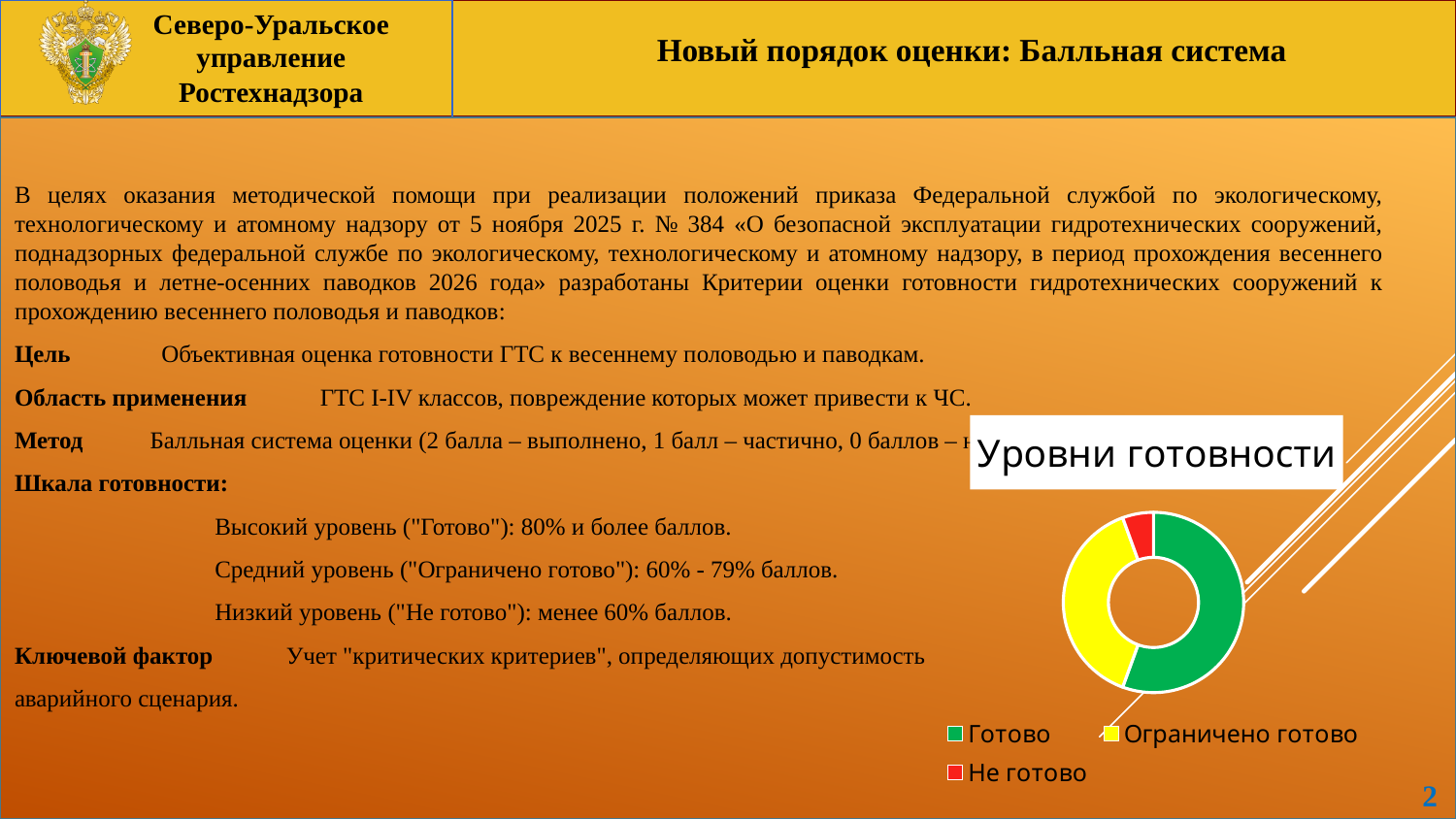
What is the title of the chart on the slide? Уровни готовности Which category is shown in yellow in the chart? Ограничено готово Which slice is larger: Готово or Ограничено готово? Готово How many categories does the chart's legend list? 3 What colour represents the category Не готово in the chart? red What kind of chart is shown on the slide? doughnut chart Which category has the largest slice in the chart? Готово Which slice is larger: Ограничено готово or Не готово? Ограничено готово Which category has the smallest slice in the chart? Не готово